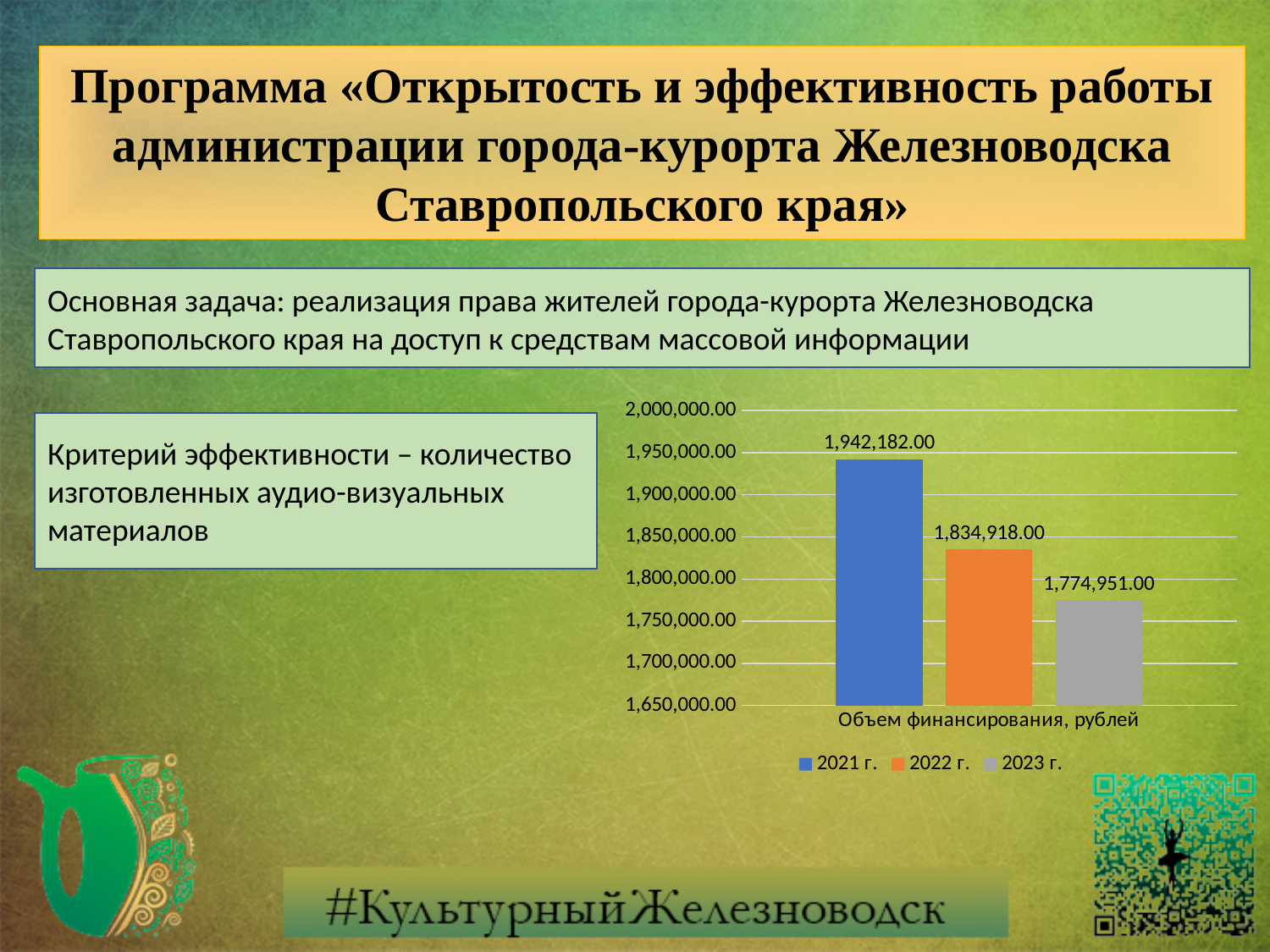
What is the value for 2023 г. in the chart? 1,774,951.00 Is the value for 2023 г. greater or less than 1,800,000.00? less What is the value for 2022 г. in the chart? 1,834,918.00 What is the category label shown on the x axis of the chart? Объем финансирования, рублей What kind of chart is shown on the slide? bar chart Which is larger, the value for 2022 г. or the value for 2023 г.? 2022 г. How many series does the legend list? 3 What is the value for 2021 г. in the chart? 1,942,182.00 What is the difference between the values for 2022 г. and 2023 г.? 59,967.00 Which year has the lowest value in the chart? 2023 г. Which year has the highest value in the chart? 2021 г. What is the difference between the values for 2021 г. and 2022 г.? 107,264.00